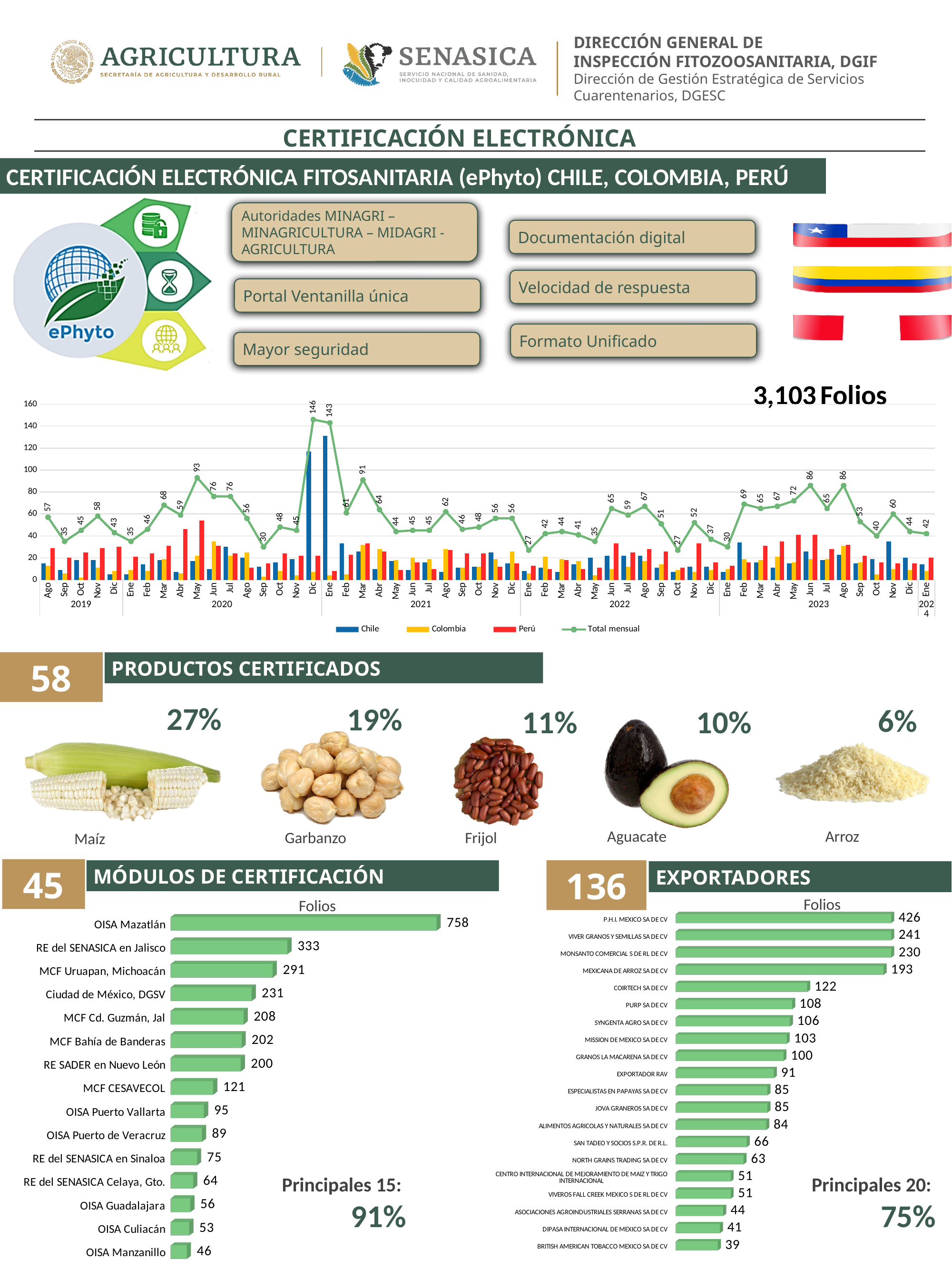
In the Exportadores chart, what is the Folios value for MEXICANA DE ARROZ SA DE CV? 193 In the Módulos de Certificación chart, which module has the lowest Folios value? OISA Manzanillo In the monthly chart at the top, what is the difference between the Total mensual values for Dic 2020 and Ene 2021? 3 What kind of chart is the Exportadores chart? bar chart In the monthly chart at the top, is the Chile value for Dic 2020 greater or less than 100? greater In the monthly chart at the top, how many series does the legend list? 4 In the Exportadores chart, which exporter has the highest Folios value? P.H.I. MEXICO SA DE CV In the Módulos de Certificación chart, what is the Folios value for OISA Mazatlán? 758 In the monthly chart at the top, which month has the highest Total mensual value? Dic 2020 In the Módulos de Certificación chart, what is the difference in Folios between OISA Mazatlán and RE del SENASICA en Jalisco? 425 In the monthly chart at the top, what is the Total mensual value for Dic 2020? 146 In the Módulos de Certificación chart, how many modules are shown? 15